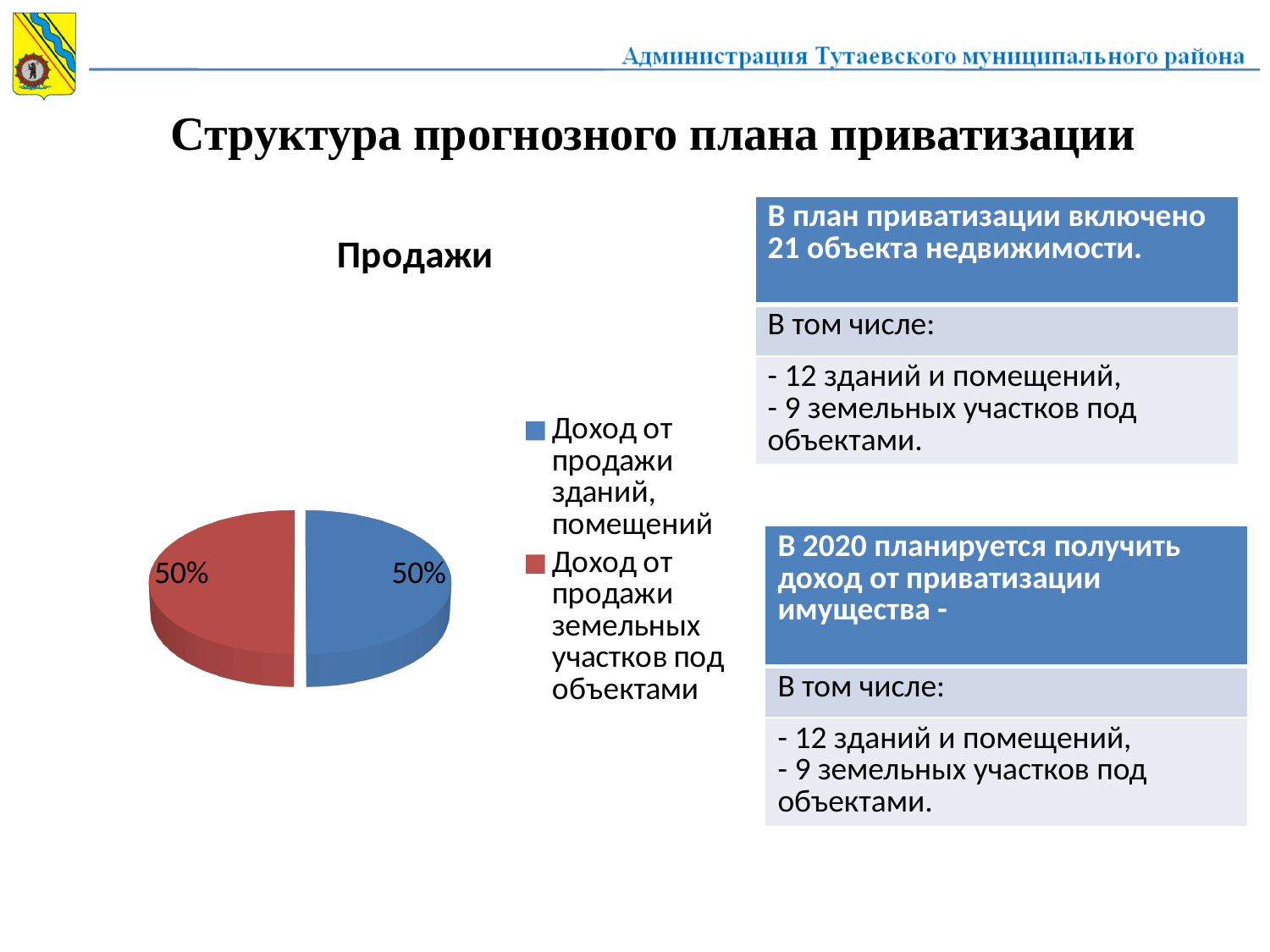
What share of the pie is labelled for "Доход от продажи земельных участков под объектами"? 50% How many slices does the pie chart have? 2 What colour is the slice for "Доход от продажи земельных участков под объектами"? red What is the difference between the shares of the two slices in the pie chart? 0% What kind of chart is shown on the slide? pie chart What is the total of the two percentages shown on the pie chart? 100% What is the title of the chart? Продажи What share of the pie is labelled for "Доход от продажи зданий, помещений"? 50% How many entries does the chart legend list? 2